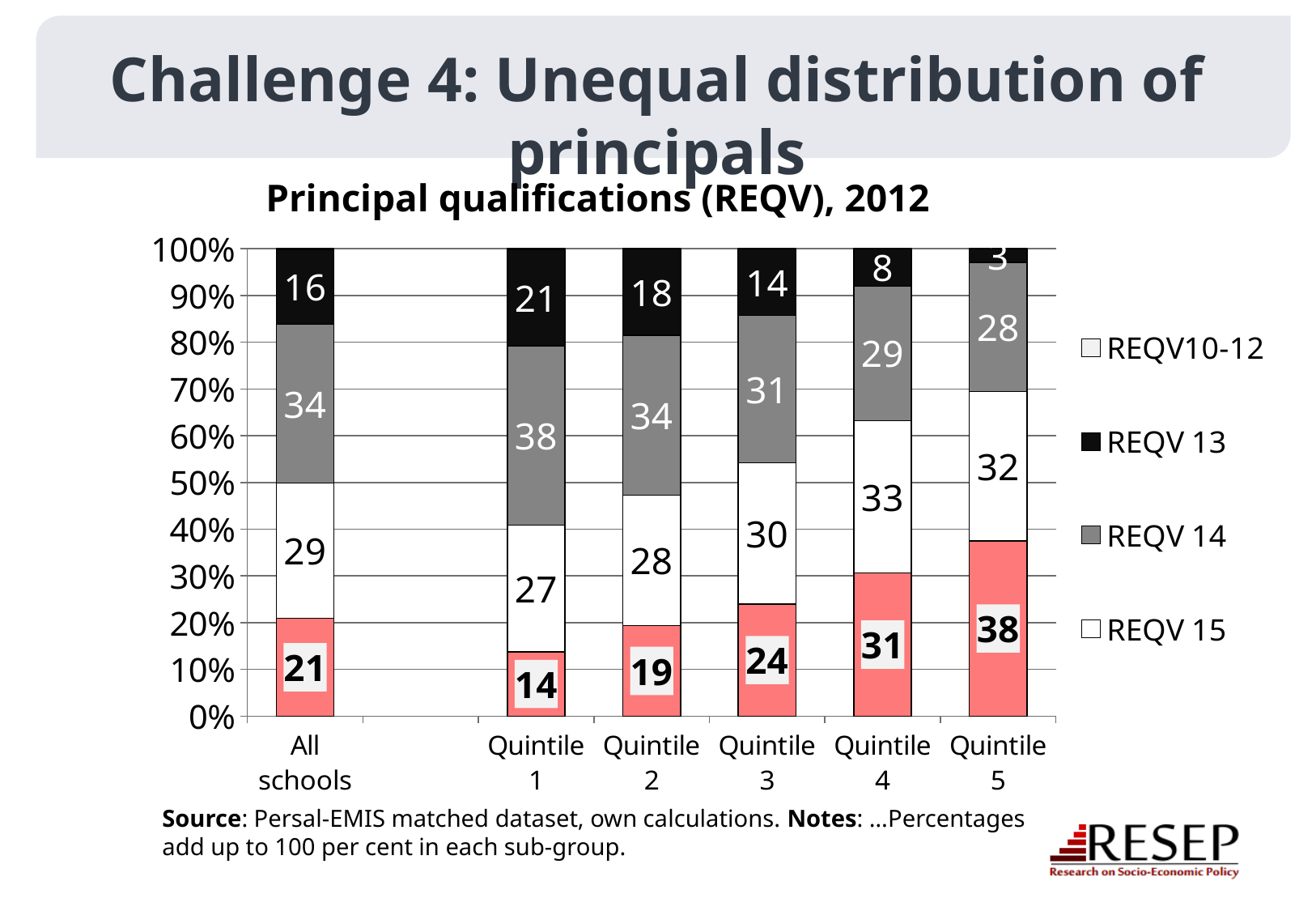
What is the REQV 13 value for Quintile 1? 21 Which category has the lowest REQV 13 value? Quintile 5 How many categories are shown on the x axis? 6 What is the value of the bottom (pink) segment for Quintile 4? 31 Does the value of the bottom (pink) segment rise or fall from Quintile 1 to Quintile 5? Rise What is the difference between the REQV 14 values for Quintile 1 and Quintile 5? 10 What is the REQV 14 value for Quintile 3? 31 What kind of chart is shown on the slide? Stacked bar chart Which has the larger REQV 13 value, Quintile 2 or Quintile 3? Quintile 2 What is the title of the chart? Principal qualifications (REQV), 2012 How many series does the legend list? 4 Which category has the highest REQV 13 value? Quintile 1